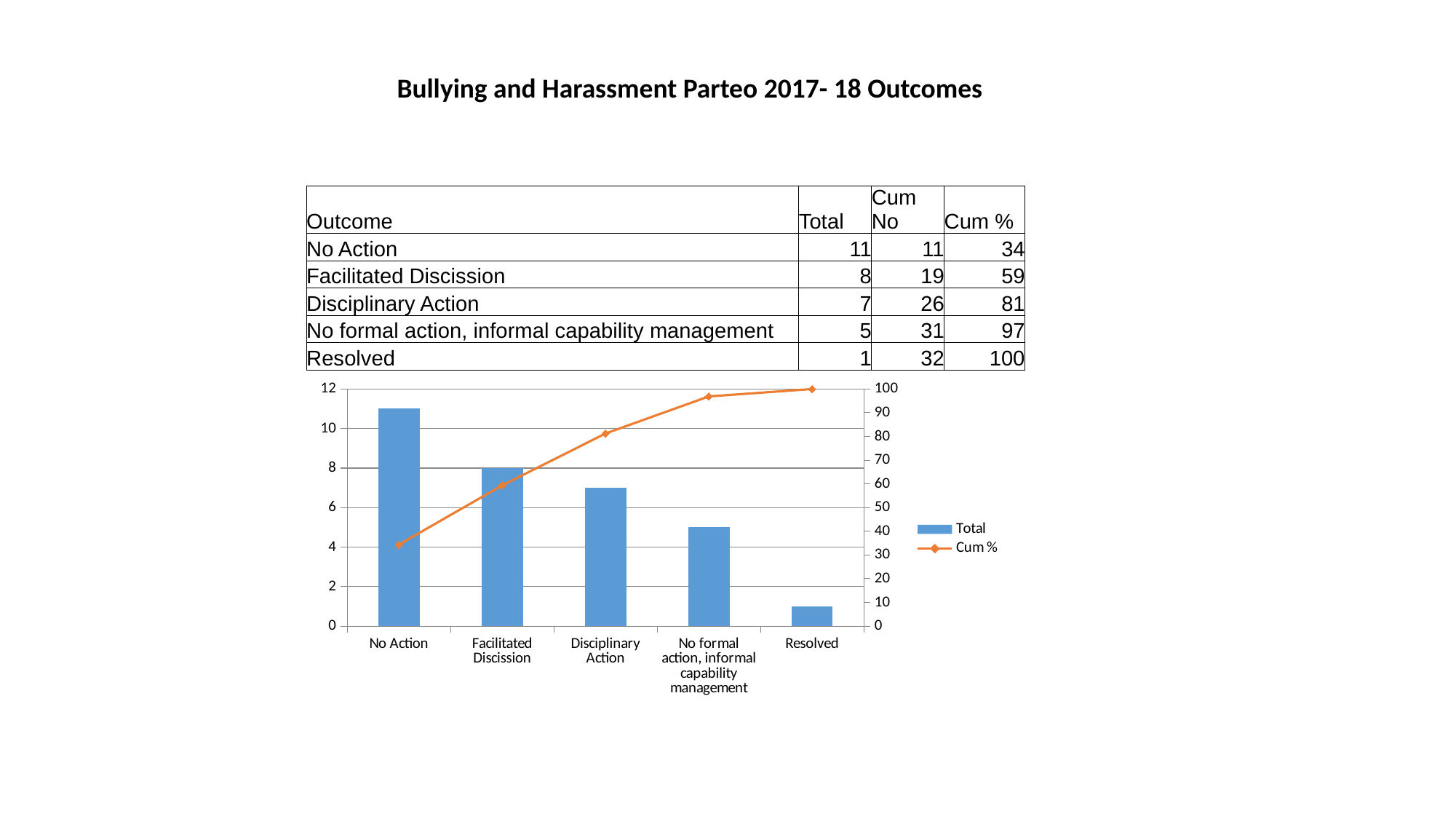
Which outcome has the highest Total? No Action What is the difference between the Total for No Action and the Total for Facilitated Discission? 3 What is the Cum % value for Disciplinary Action? 81 What is the title of the slide? Bullying and Harassment Parteo 2017- 18 Outcomes Which has a larger Total, Disciplinary Action or Resolved? Disciplinary Action Do the Total bars rise or fall from left to right along the x axis? fall How many outcome categories are shown on the x axis of the chart? 5 How many series does the chart legend list? 2 Which outcome has the lowest Total? Resolved Is the Total for No formal action, informal capability management greater or less than 6? less What is the Total value for No Action? 11 What kind of chart is shown on the slide? Combined bar and line chart